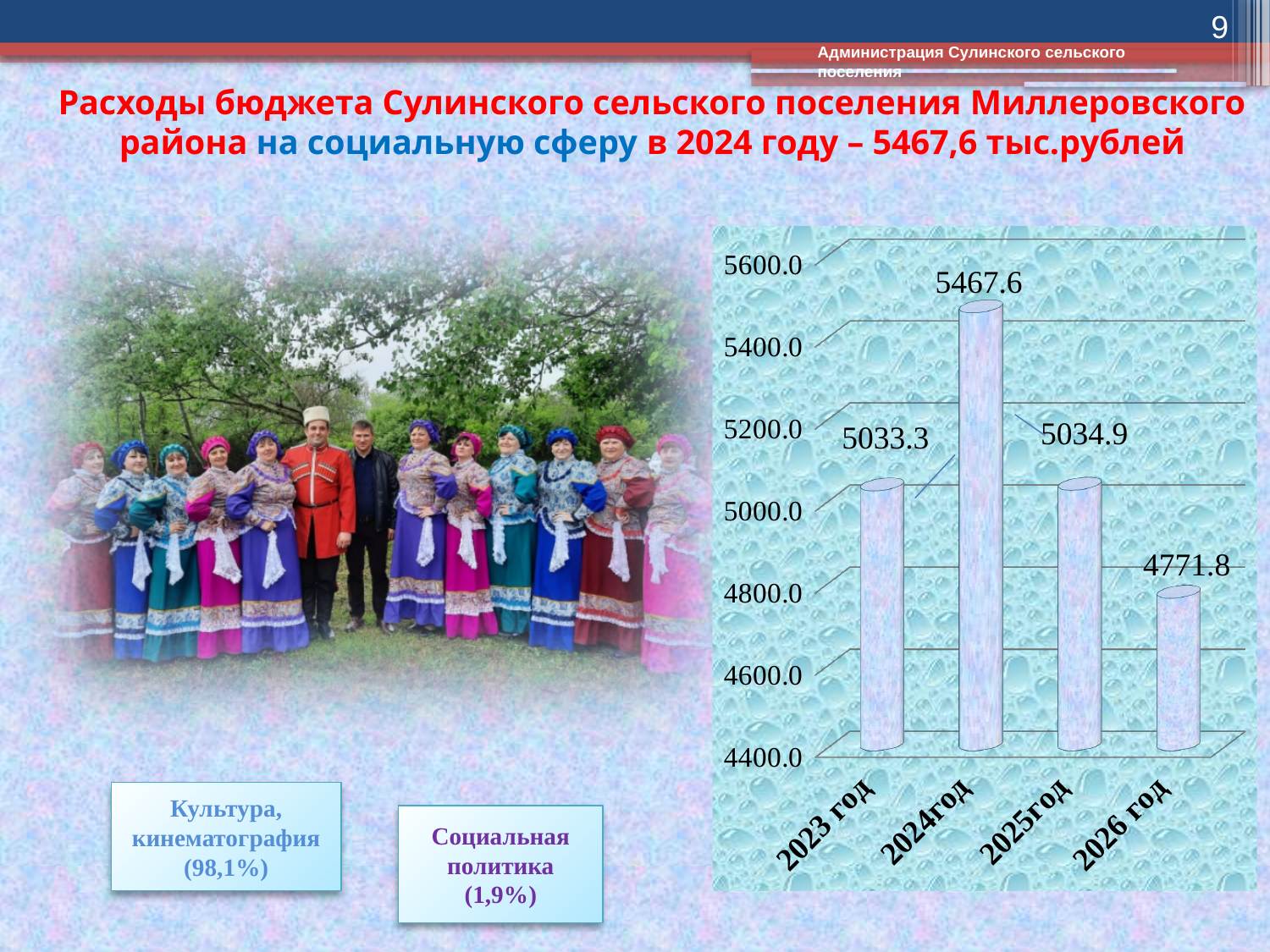
Which is larger, the value for 2024год or the value for 2025год? 2024год Which year has the lowest value? 2026 год What is the value for 2025год? 5034.9 What is the value for 2023 год? 5033.3 What is the difference between the values for 2024год and 2026 год? 695.8 How many years are shown on the chart? 4 What kind of chart is shown on the slide? bar chart What is the difference between the values for 2024год and 2023 год? 434.3 Which year has the highest value? 2024год Is the value for 2026 год greater or less than 5000.0? less What is the value for 2024год? 5467.6 What is the value for 2026 год? 4771.8